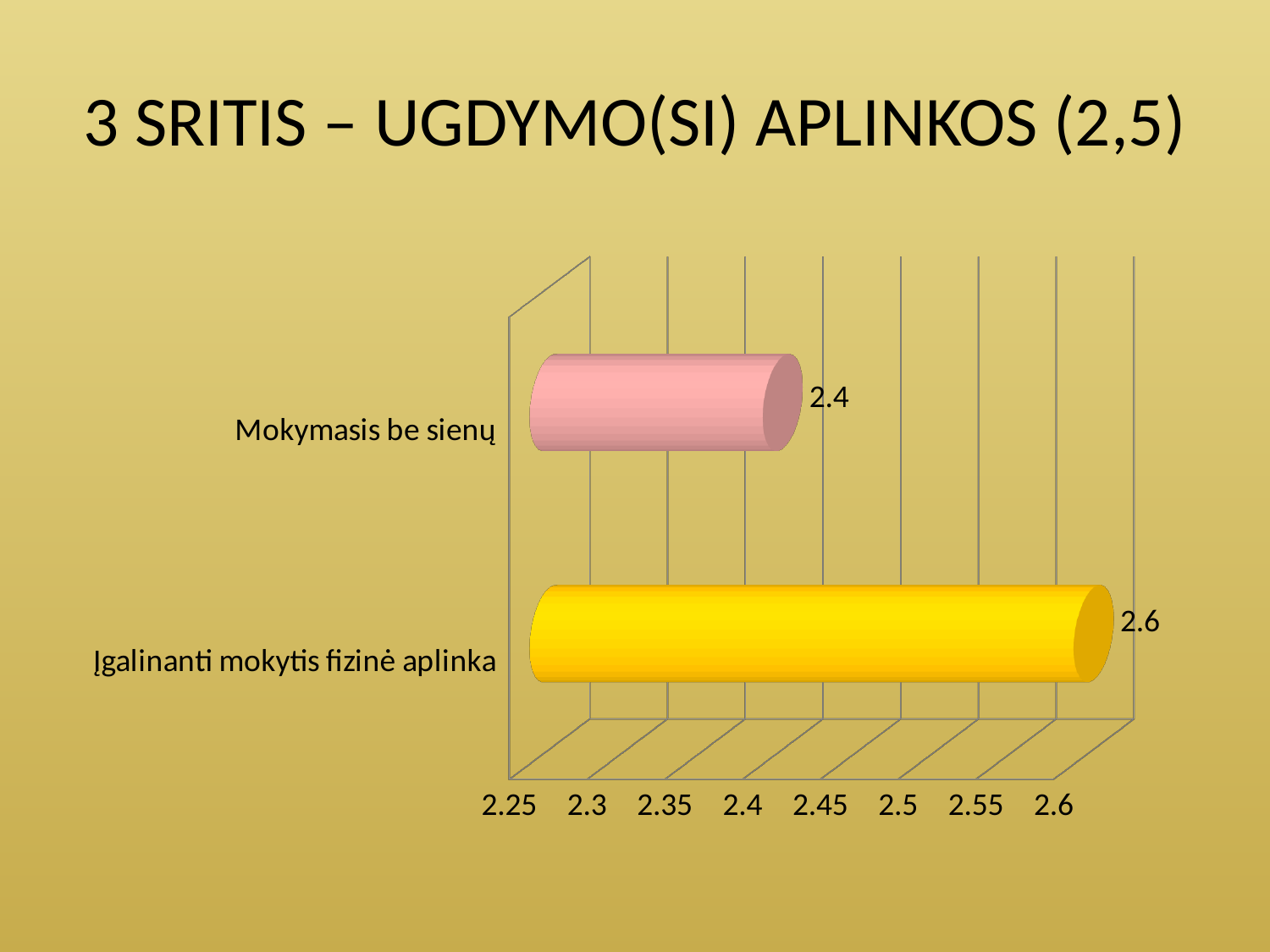
Which category has the highest value? Įgalinanti mokytis fizinė aplinka Which category has the lowest value? Mokymasis be sienų Is the value for Įgalinanti mokytis fizinė aplinka greater or less than 2.5? greater What is the value for Įgalinanti mokytis fizinė aplinka? 2.6 What is the value for Mokymasis be sienų? 2.4 What is the title of the slide? 3 SRITIS – UGDYMO(SI) APLINKOS (2,5) Is the value for Mokymasis be sienų greater or less than 2.5? less What kind of chart is shown on the slide? bar chart What colour is the bar for Įgalinanti mokytis fizinė aplinka? yellow What is the difference between the values for Įgalinanti mokytis fizinė aplinka and Mokymasis be sienų? 0.2 Which is larger, the value for Mokymasis be sienų or the value for Įgalinanti mokytis fizinė aplinka? Įgalinanti mokytis fizinė aplinka How many categories are shown in the chart? 2